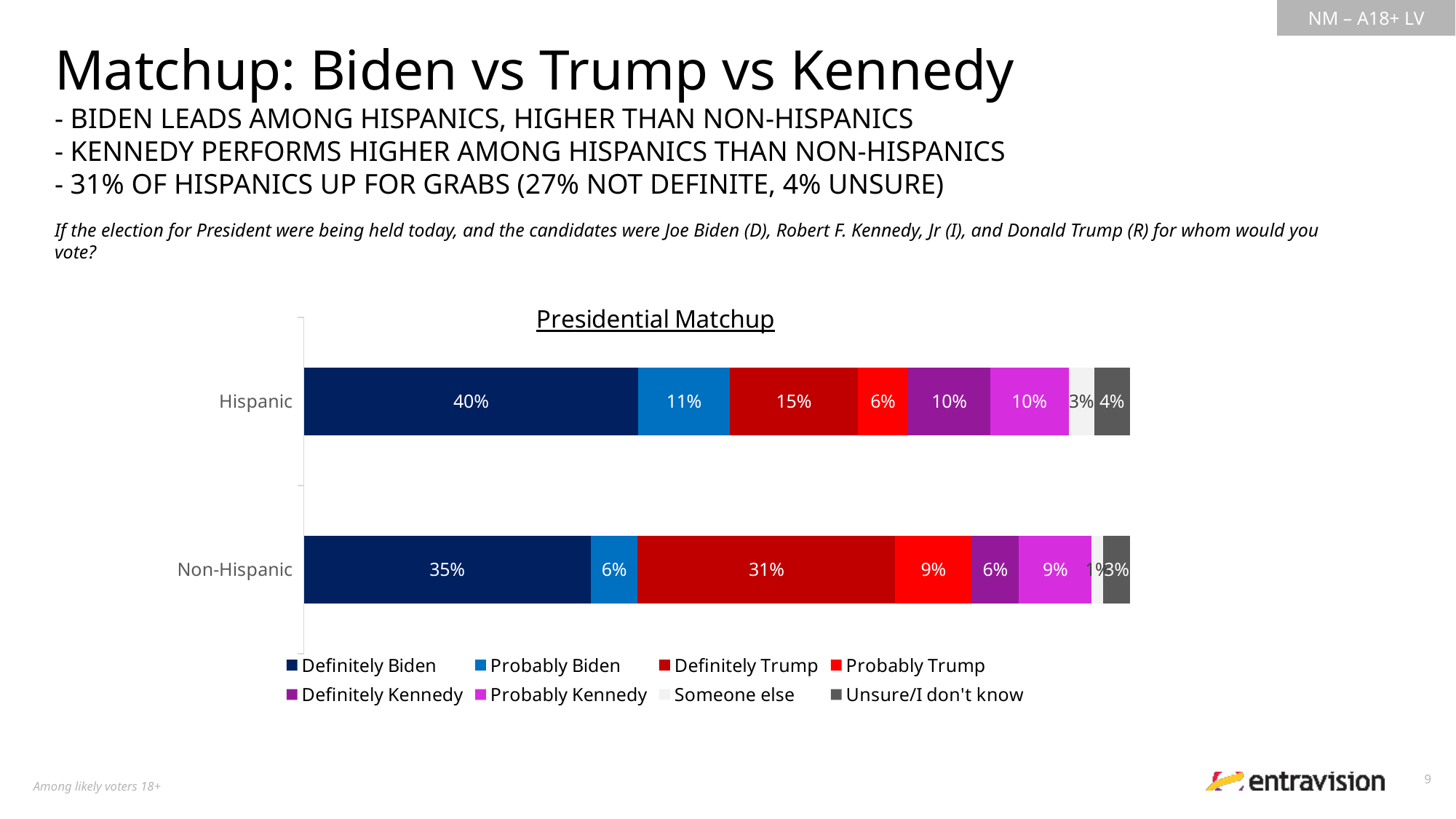
How many categories are plotted on the Presidential Matchup chart? 2 What kind of chart is shown under the title "Presidential Matchup"? Stacked bar chart What is the difference between the Definitely Kennedy values for Hispanic and Non-Hispanic voters? 4% What is the Probably Kennedy value for Hispanic voters? 10% Which series is shown in dark grey in the legend of the Presidential Matchup chart? Unsure/I don't know Which series has the largest segment in the Hispanic bar? Definitely Biden What is the Definitely Trump value for Non-Hispanic voters? 31% What is the Definitely Biden value for Hispanic voters? 40% What is the difference between the Definitely Biden values for Hispanic and Non-Hispanic voters? 5% How many series does the legend of the Presidential Matchup chart list? 8 Which category has the higher Definitely Trump value, Hispanic or Non-Hispanic? Non-Hispanic What is the Unsure/I don't know value for Non-Hispanic voters? 3%